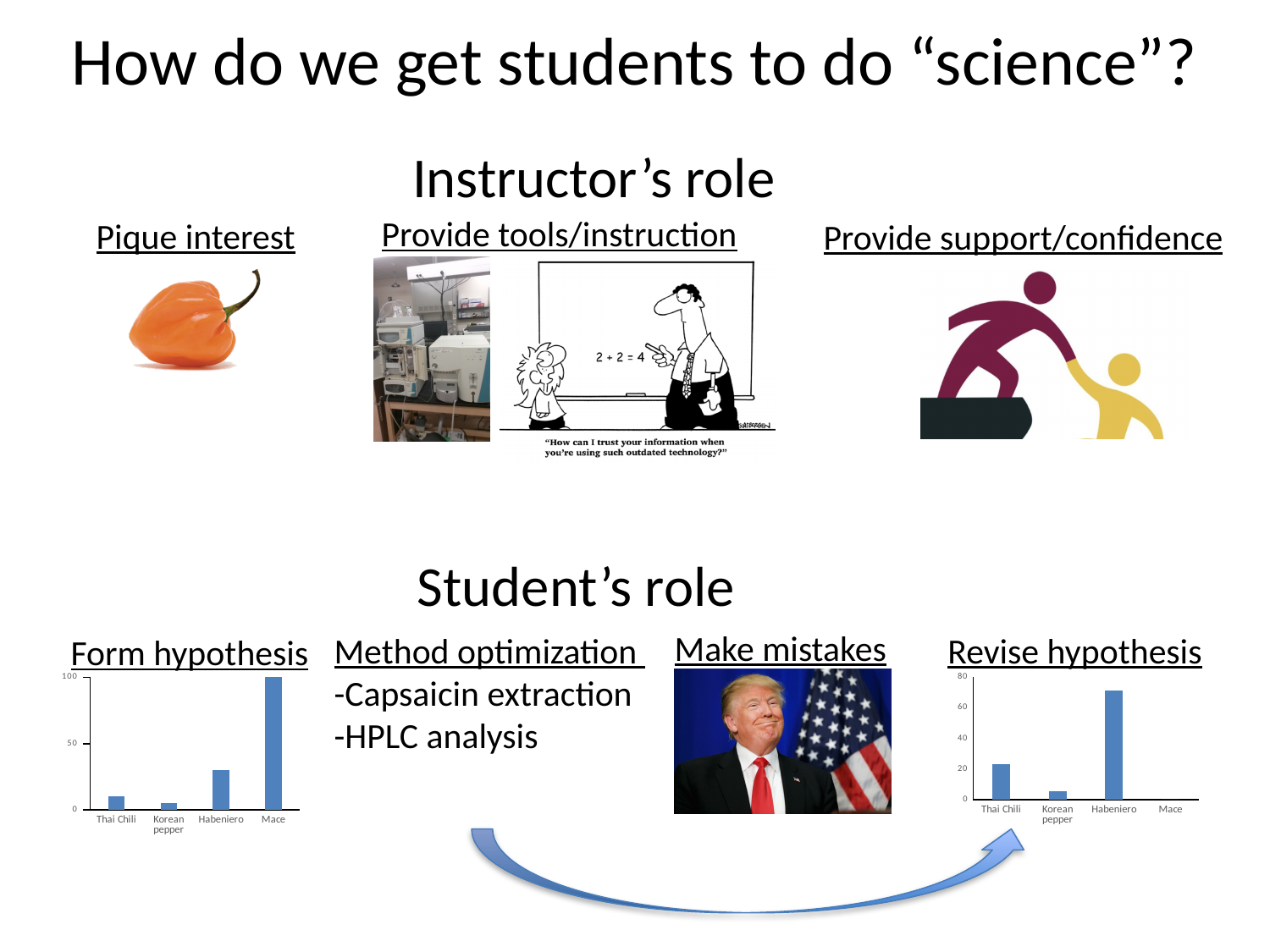
In the chart under "Form hypothesis", which category has the lowest bar? Korean pepper In the chart under "Revise hypothesis", is the value for Thai Chili greater or less than 40? less In the chart under "Form hypothesis", is the value for Mace greater or less than 50? greater In the chart under "Revise hypothesis", which category has the highest bar? Habeniero What is the highest value shown on the y axis of the chart under "Revise hypothesis"? 80 In the chart under "Form hypothesis", which category has the highest bar? Mace What kind of chart is shown under "Form hypothesis"? bar chart In the chart under "Revise hypothesis", which is larger, the value for Thai Chili or the value for Korean pepper? Thai Chili In the chart under "Form hypothesis", which is larger, the value for Thai Chili or the value for Habeniero? Habeniero How many categories are shown on the x axis of the chart under "Form hypothesis"? 4 In the chart under "Form hypothesis", is the value for Habeniero greater or less than 50? less